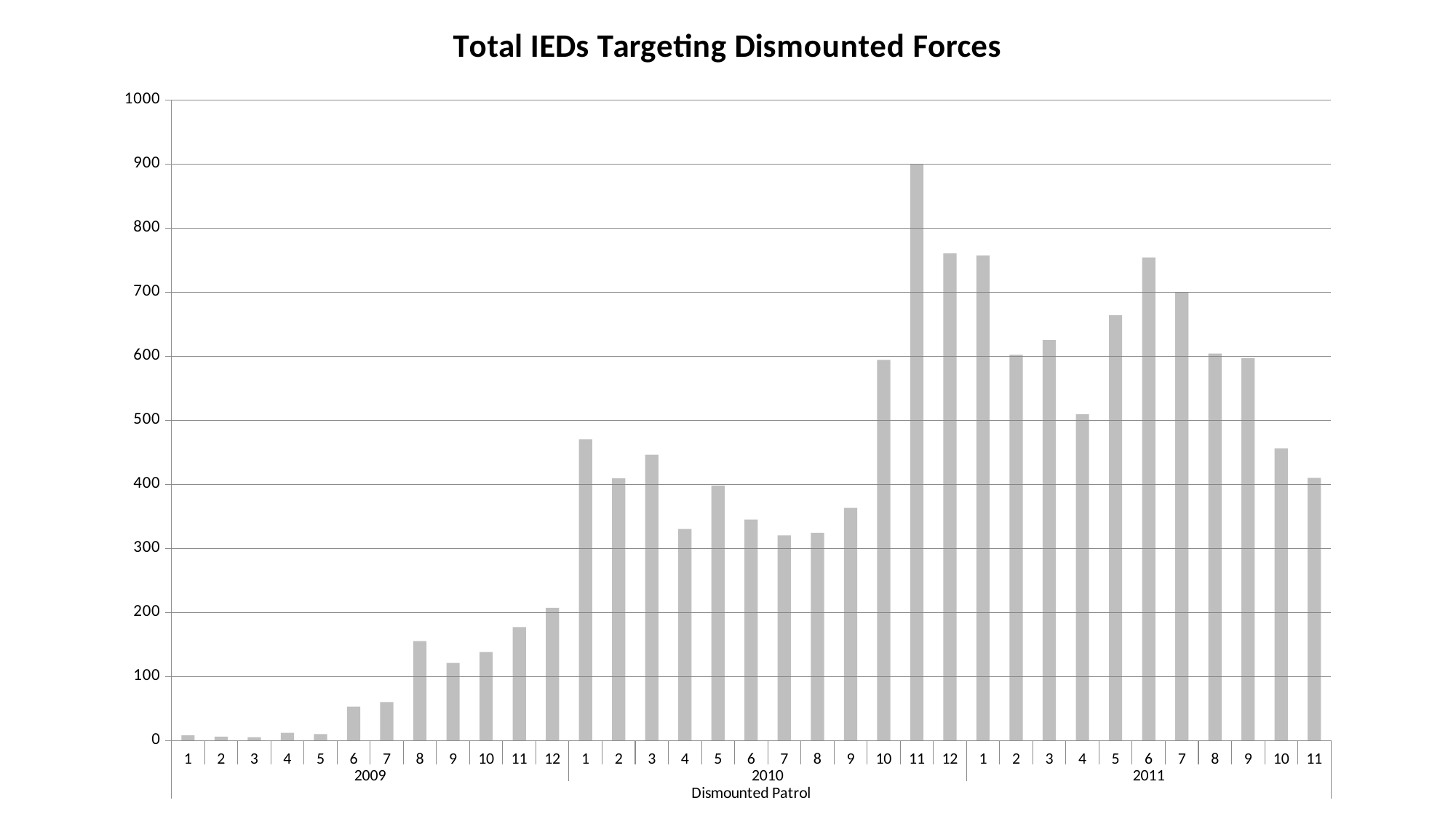
Which is larger, the value for month 12 of 2009 or the value for month 1 of 2010? Month 1 of 2010 Is the value for month 1 of 2010 greater or less than 400? greater Which month has the highest value in the chart? Month 11 of 2010 Which is larger, the value for month 4 of 2011 or the value for month 6 of 2011? Month 6 of 2011 How many bars are plotted in the chart? 35 Is the value for month 6 of 2011 greater or less than 700? greater What kind of chart is shown on the slide? bar chart Is the value for month 11 of 2010 greater or less than 800? greater What is the title of the chart? Total IEDs Targeting Dismounted Forces Do the values generally rise or fall across the months of 2009? rise